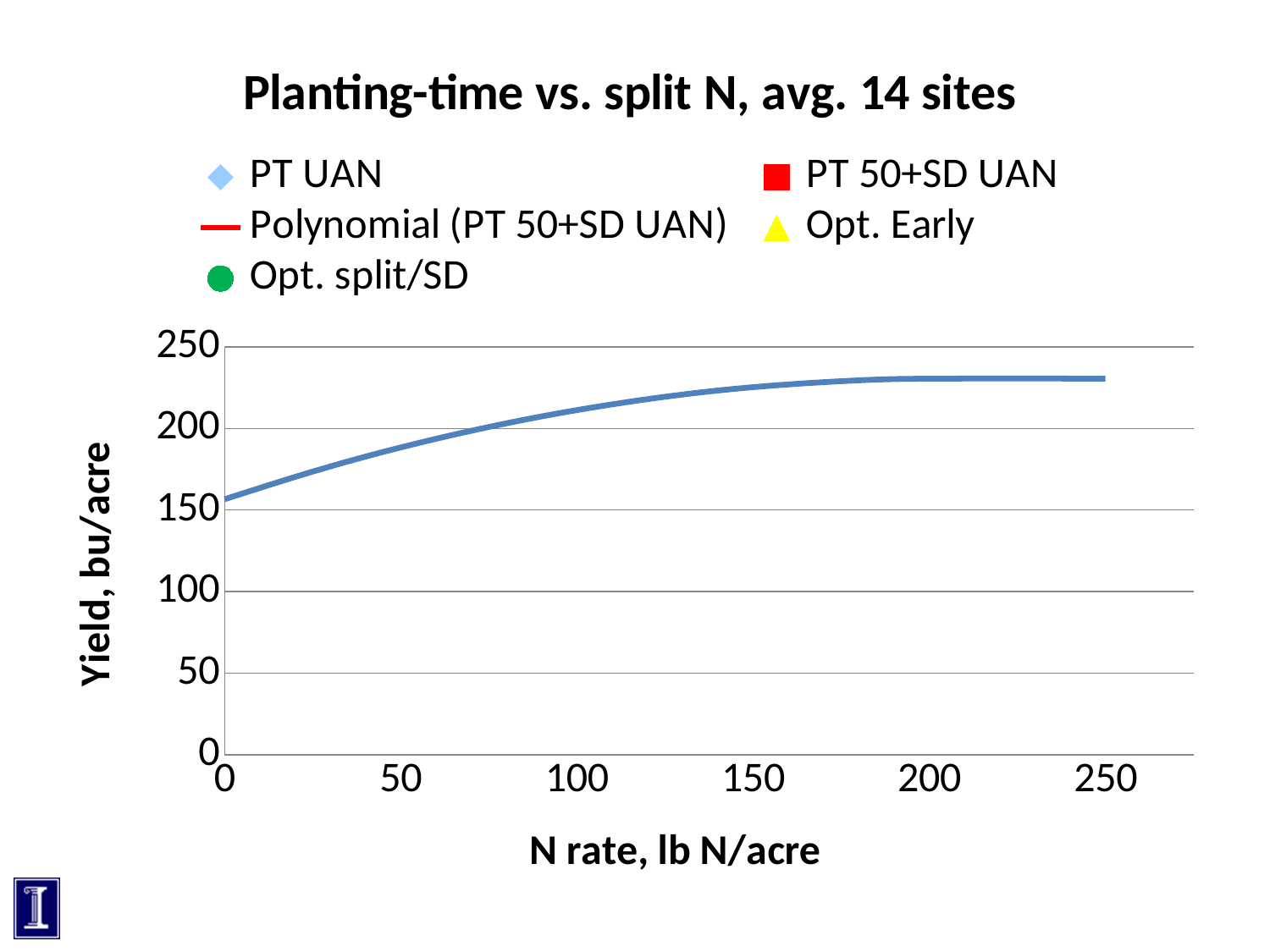
Is the yield on the curve higher at an N rate of 250 or at an N rate of 50? 250 How many entries does the chart legend list? 5 What is the title of the chart? Planting-time vs. split N, avg. 14 sites Is the yield on the curve at an N rate of 50 greater or less than 200? less Does the plotted curve rise or fall as N rate increases from 0 to 250? rise Is the yield on the curve at an N rate of 200 greater or less than 250? less Is the yield on the curve at an N rate of 150 greater or less than 200? greater What is the highest value shown on the y axis? 250 What is the label of the y axis? Yield, bu/acre